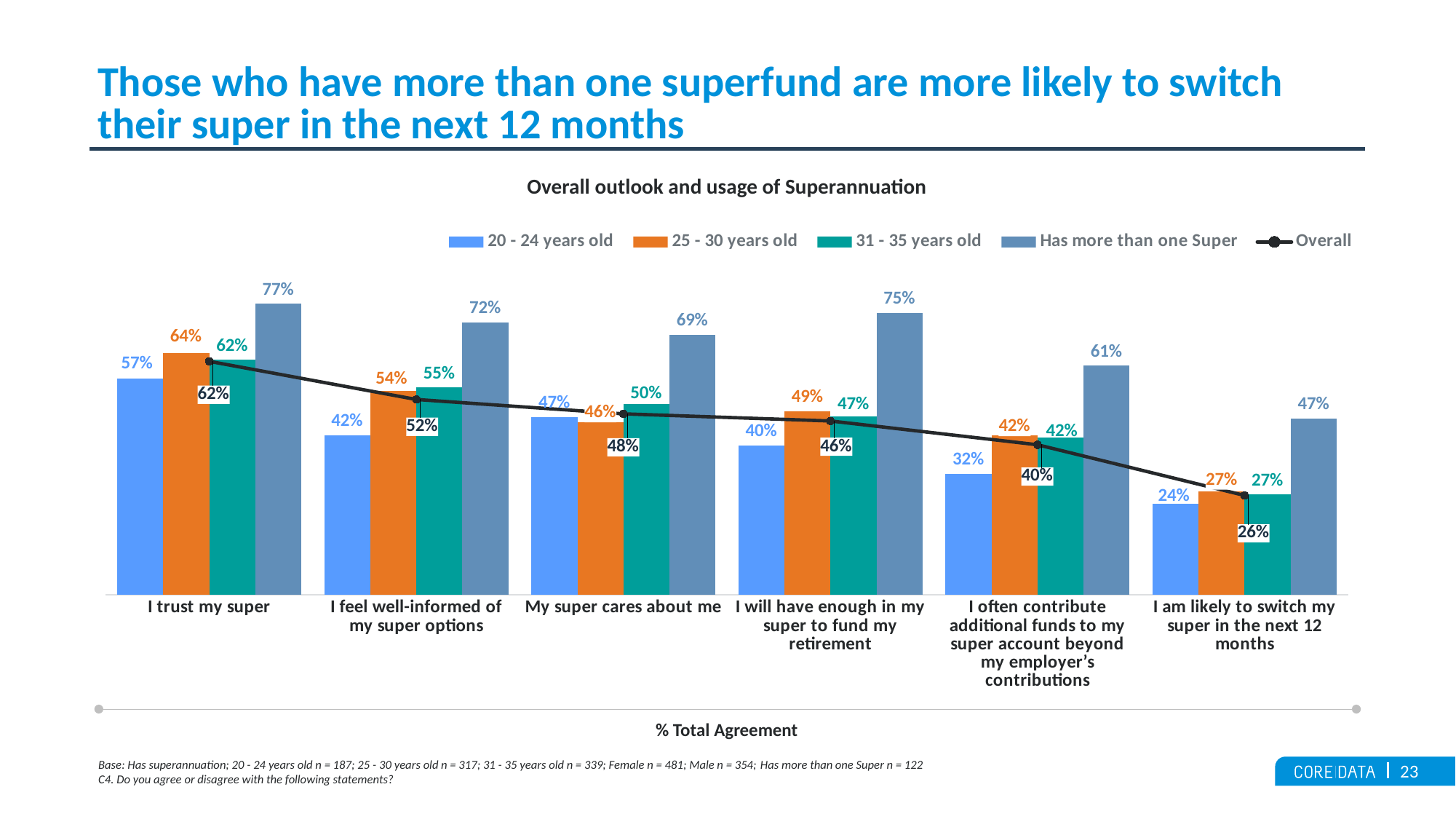
What is the Overall value for 'I feel well-informed of my super options'? 52% What is the value for 'Has more than one Super' for 'I trust my super'? 77% What is the value for '20 - 24 years old' for 'I am likely to switch my super in the next 12 months'? 24% What is the value for '25 - 30 years old' for 'I will have enough in my super to fund my retirement'? 49% Which statement has the highest value for 'Has more than one Super'? I trust my super For 'My super cares about me', which is larger: the value for '31 - 35 years old' or for '25 - 30 years old'? 31 - 35 years old How many series does the legend list? 5 How many statements (categories) are shown on the x axis? 6 What kind of chart is this? Bar chart with a line series Which statement has the lowest Overall value? I am likely to switch my super in the next 12 months Does the Overall line rise or fall from left to right across the statements? Fall What is the difference between the 'Has more than one Super' value and the '20 - 24 years old' value for 'I am likely to switch my super in the next 12 months'? 23%